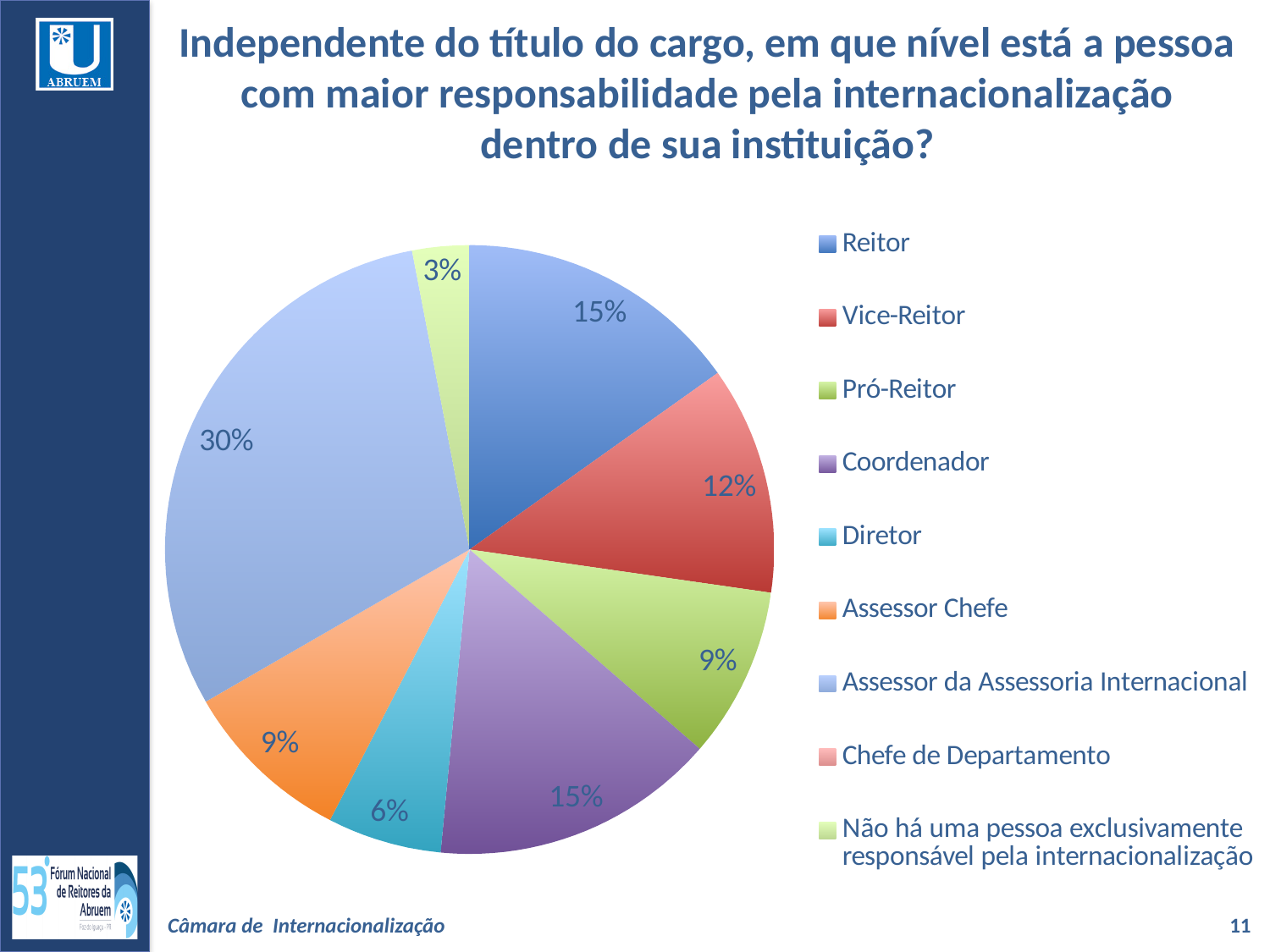
What share of the pie does Assessor da Assessoria Internacional hold? 30% What percentage of the pie corresponds to Reitor? 15% What kind of chart is shown on the slide? Pie chart What percentage is shown for Assessor Chefe? 9% What is the difference in percentage points between Assessor da Assessoria Internacional and Reitor? 15 Which category has the largest slice of the pie? Assessor da Assessoria Internacional Which is larger, the slice for Vice-Reitor or the slice for Pró-Reitor? Vice-Reitor What percentage is shown for Vice-Reitor? 12% What colour is the slice for Reitor? Blue What percentage is shown for Diretor? 6% How many entries does the legend list? 9 What percentage is shown for Coordenador? 15%